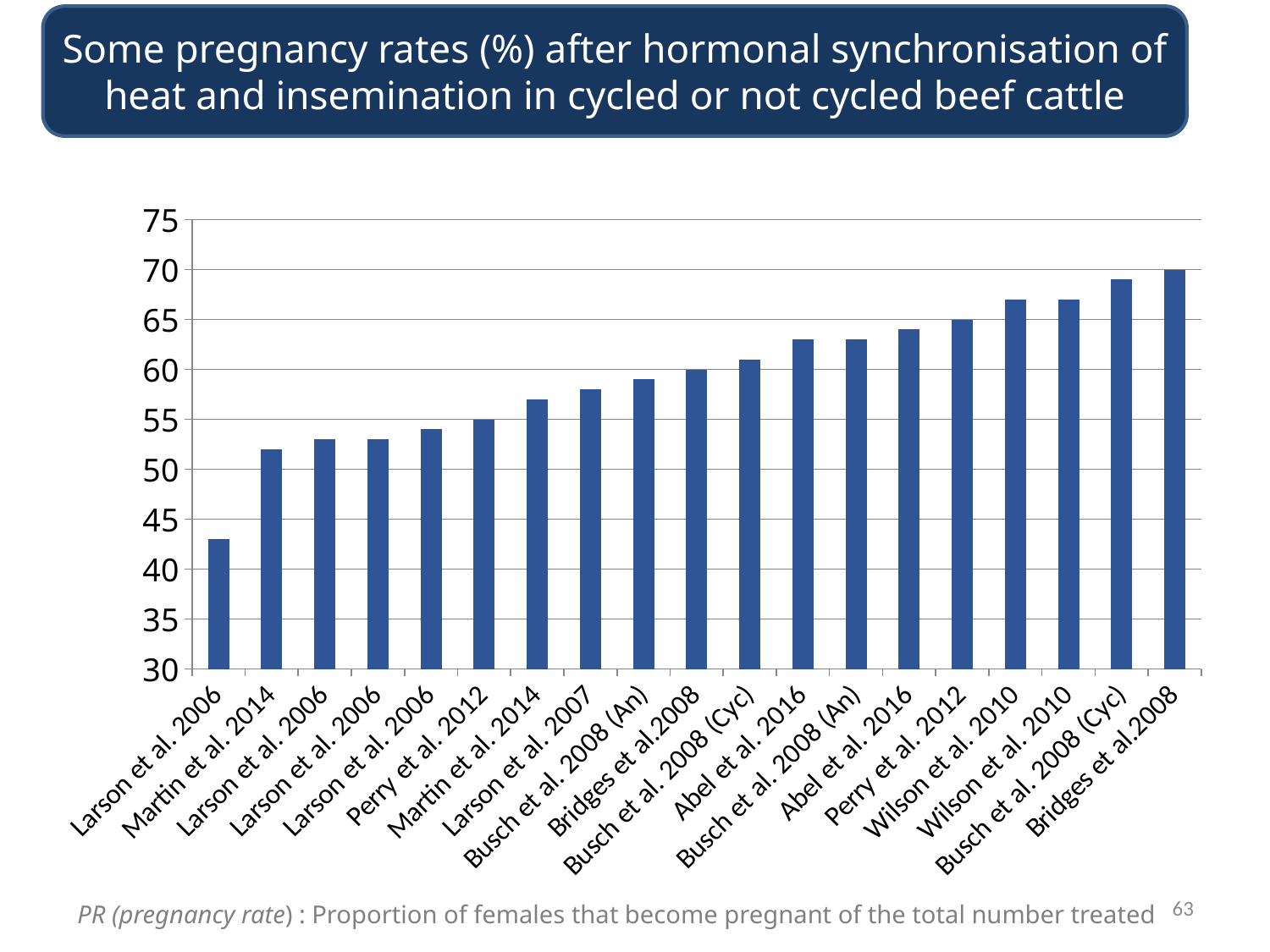
Is the value for the leftmost Larson et al. 2006 bar greater or less than 45? less Is the value for the rightmost Busch et al. 2008 (Cyc) bar greater or less than 65? greater What is the highest value shown on the vertical axis? 75 Is the value for Larson et al. 2007 greater or less than 55? greater What is the lowest value shown on the vertical axis? 30 Which bar has the lowest pregnancy rate? Larson et al. 2006 (leftmost bar) How many bars are plotted in the chart? 19 What kind of chart is shown on the slide? bar chart Do the bar values rise or fall from left to right along the x axis? rise What is the value of the rightmost bar, Bridges et al.2008? 70 Which is larger, the leftmost Larson et al. 2006 bar or the leftmost Martin et al. 2014 bar? Martin et al. 2014 What is the value of the first (leftmost) Perry et al. 2012 bar? 55